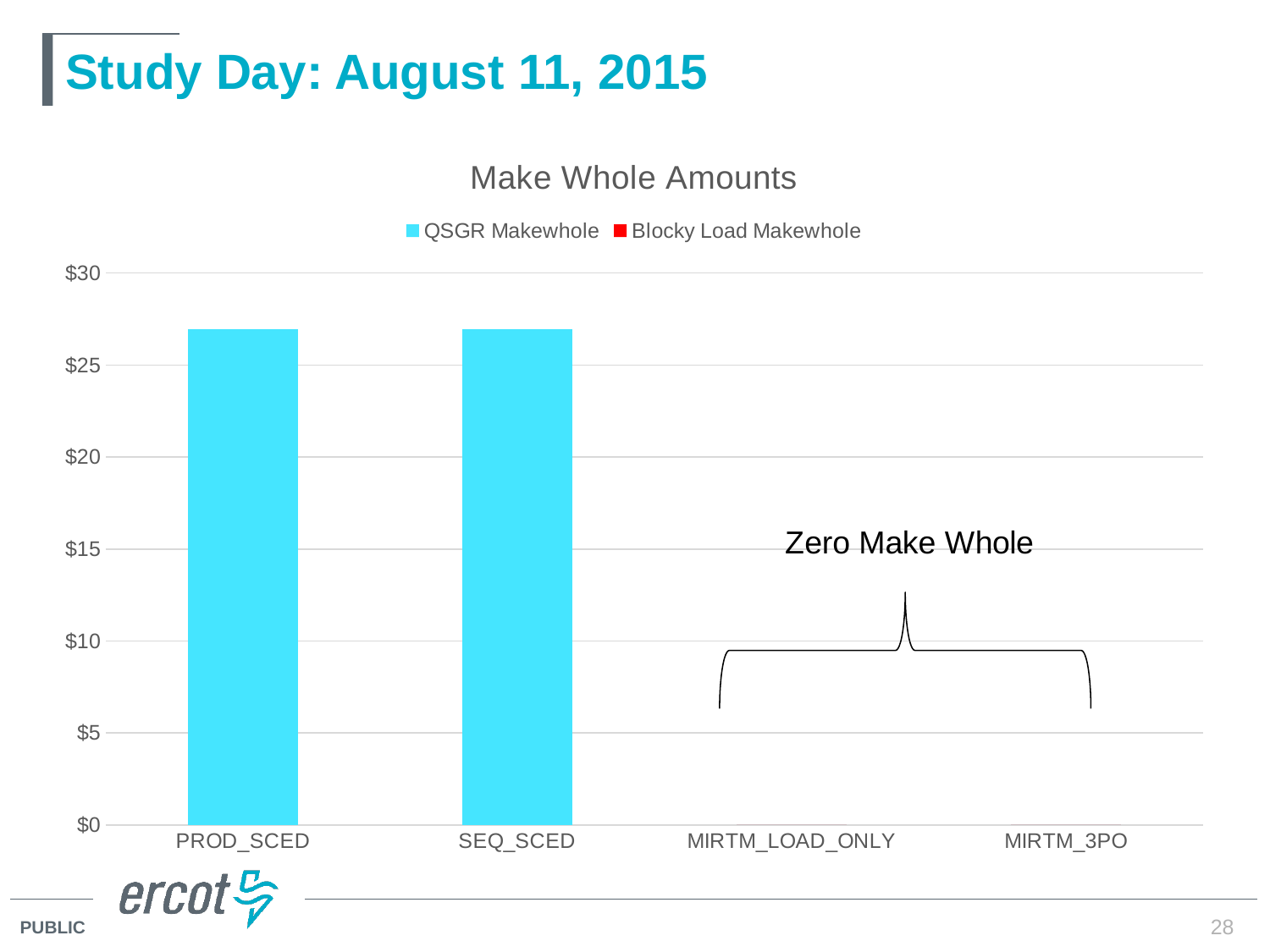
Which is larger, the QSGR Makewhole value for SEQ_SCED or for MIRTM_LOAD_ONLY? SEQ_SCED Which is larger, the QSGR Makewhole value for PROD_SCED or for MIRTM_3PO? PROD_SCED Is the QSGR Makewhole value for PROD_SCED greater or less than $25? greater Which series in the legend is shown in red? Blocky Load Makewhole Is the QSGR Makewhole value for SEQ_SCED greater or less than $30? less What kind of chart is shown on the slide? bar chart What does the annotation on the chart say about the MIRTM_LOAD_ONLY and MIRTM_3PO categories? Zero Make Whole Is the QSGR Makewhole value for SEQ_SCED greater or less than $20? greater How many series does the chart legend list? 2 What is the title of the chart? Make Whole Amounts How many categories are shown on the x axis of the chart? 4